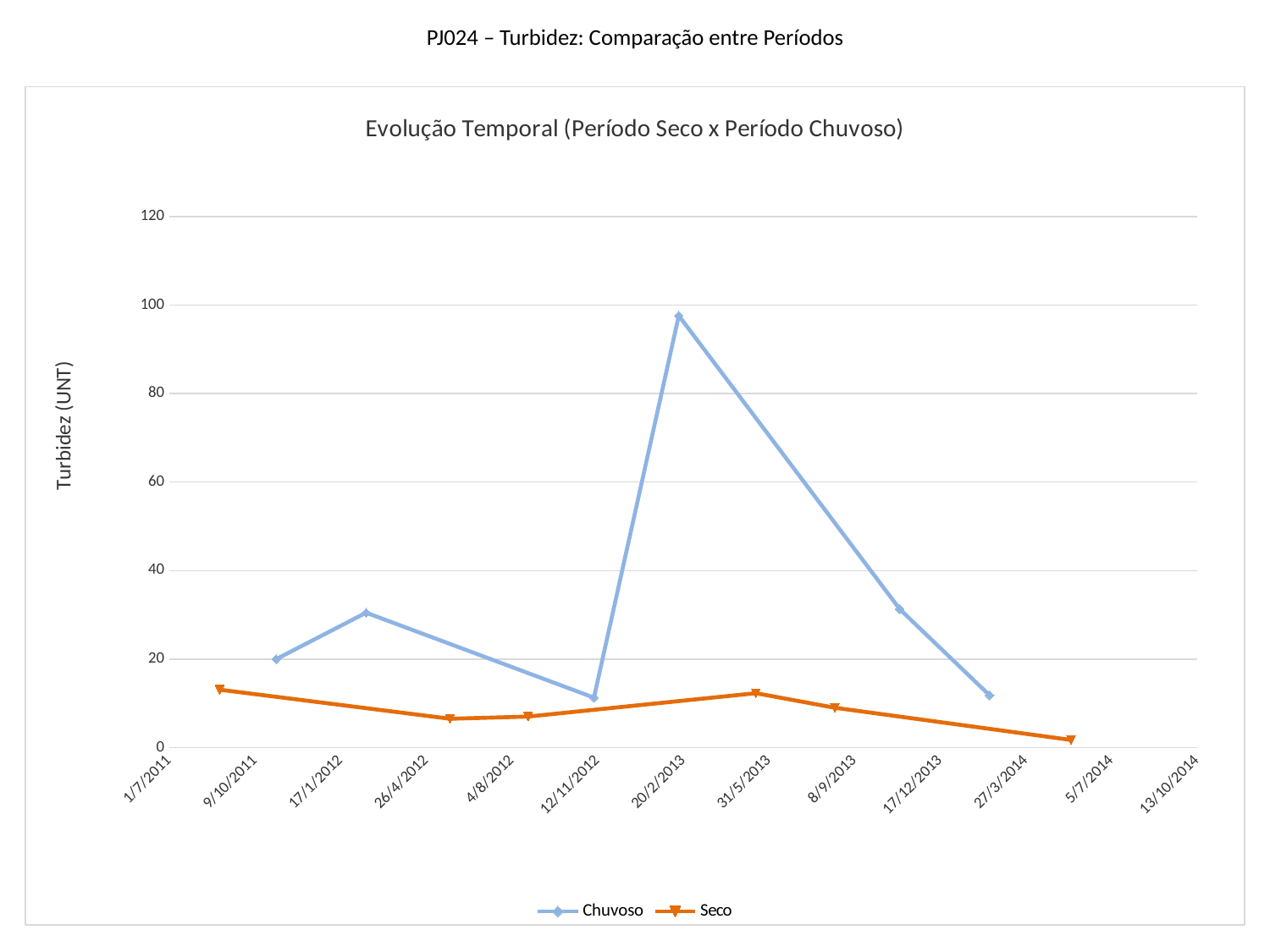
What kind of chart is shown on the slide? line chart How many data points does the Seco series have? 6 What are the two series named in the legend? Chuvoso and Seco Do the Seco values rise or fall over the last three plotted points? fall How many series does the legend list? 2 Is the highest value of the Chuvoso series greater or less than 80? greater Is the first plotted value of the Chuvoso series greater or less than 40? less Which series has the larger value at its last plotted point, Chuvoso or Seco? Chuvoso How many data points does the Chuvoso series have? 6 Which series reaches the highest value on the chart? Chuvoso Is the highest value of the Seco series greater or less than 20? less What is the label of the vertical axis? Turbidez (UNT)